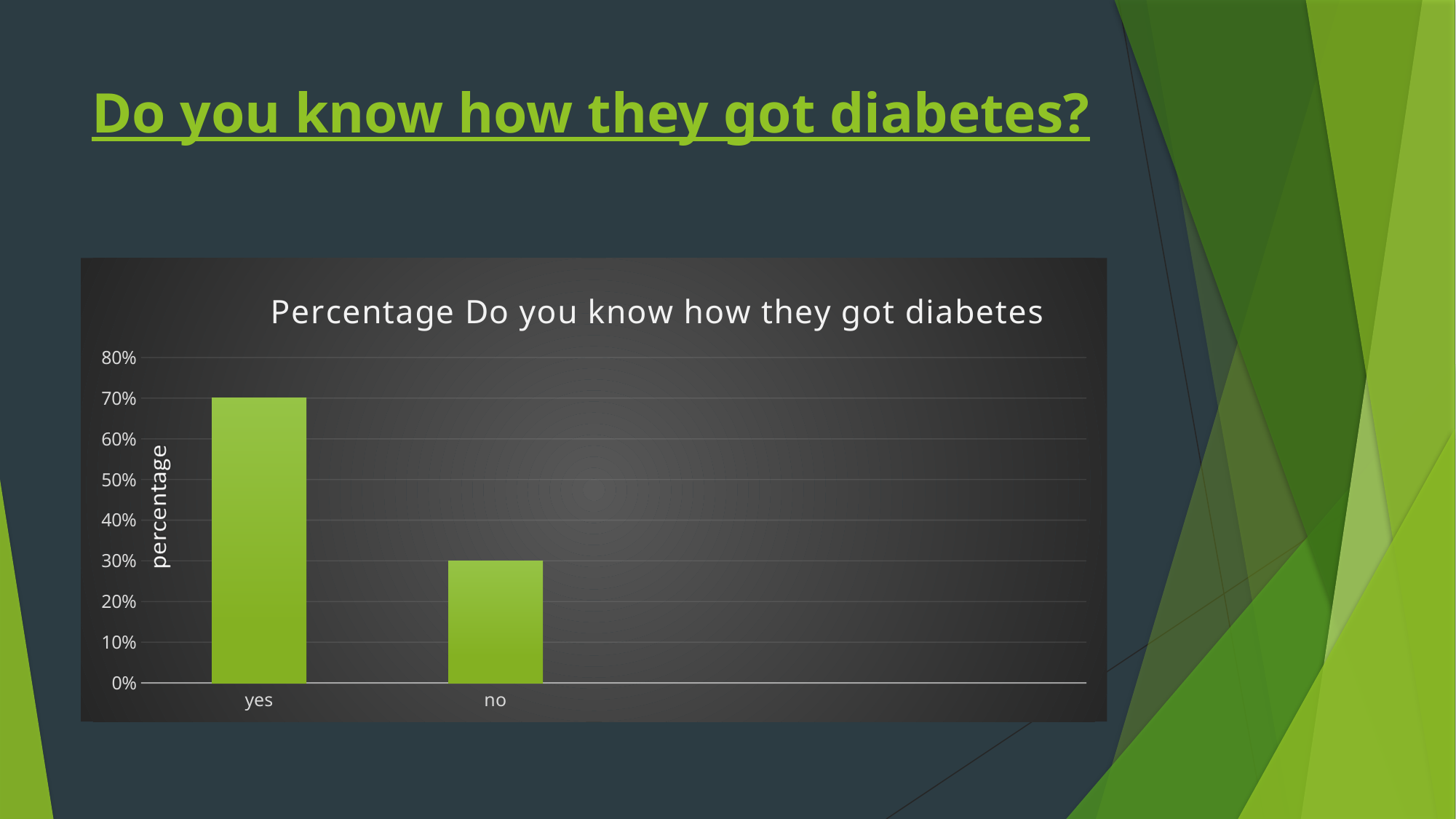
What is the value for "yes"? 70% What type of chart is shown on the slide? bar chart What is the label of the vertical axis? percentage Which is larger, the value for "yes" or the value for "no"? yes Which category has the highest value? yes Which category has the lowest value? no How many categories are shown on the x axis of the chart? 2 What is the difference between the values for "yes" and "no"? 40% What is the title of the chart? Percentage Do you know how they got diabetes What is the value for "no"? 30% Is the value for "yes" greater or less than 60%? greater Is the value for "no" greater or less than 50%? less